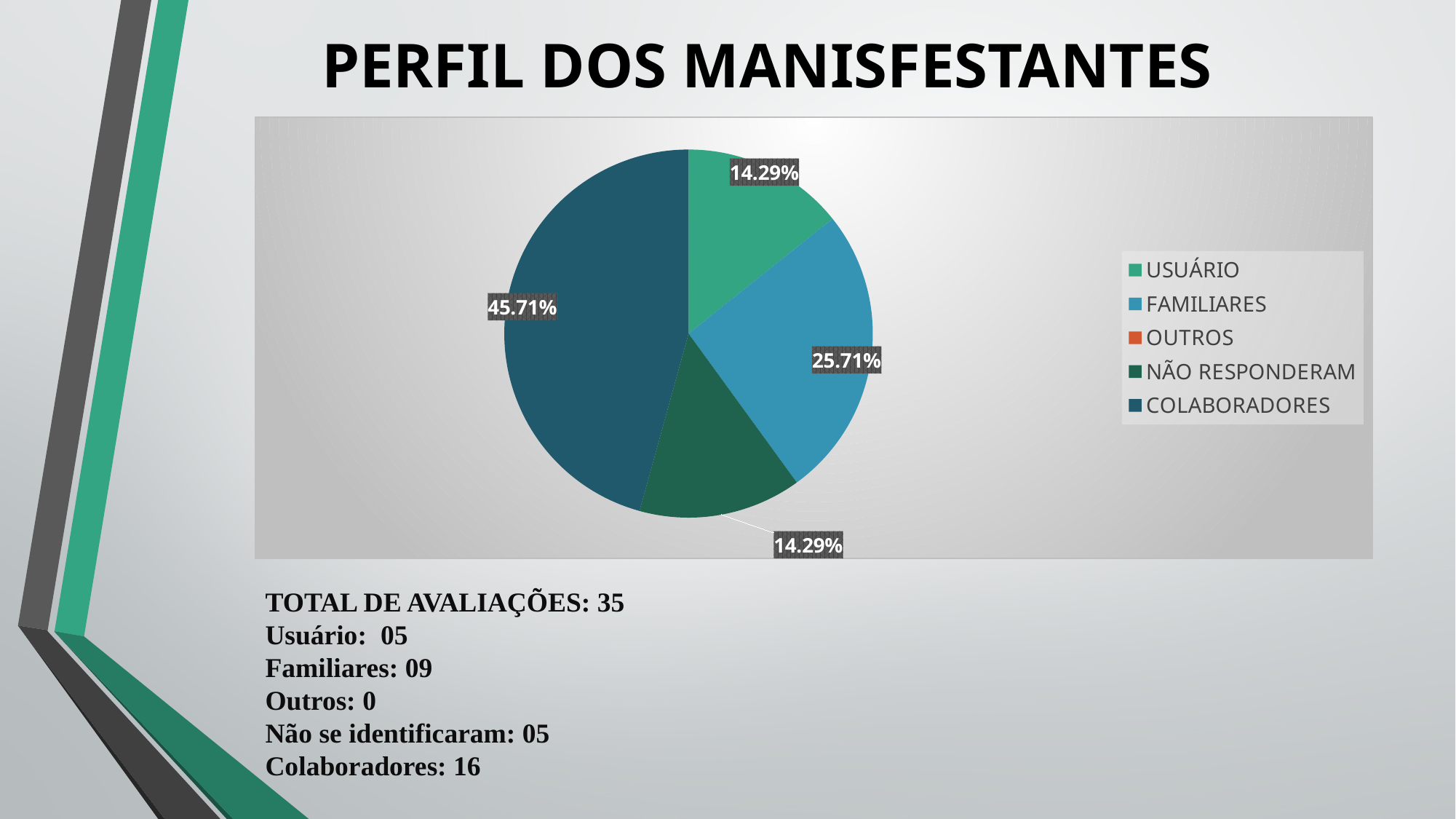
What is the difference in percentage points between the FAMILIARES slice and the USUÁRIO slice? 11.42 percentage points What is the difference in percentage points between the COLABORADORES slice and the FAMILIARES slice? 20 percentage points What share of the pie does USUÁRIO represent? 14.29% What kind of chart is shown on the slide? pie chart What share of the pie does COLABORADORES represent? 45.71% What share of the pie does NÃO RESPONDERAM represent? 14.29% Which category has the largest slice of the pie? COLABORADORES How many categories does the legend list? 5 Which of FAMILIARES or USUÁRIO has the larger slice? FAMILIARES Which legend category has no visible slice in the pie? OUTROS What is the title of the slide containing the chart? PERFIL DOS MANISFESTANTES